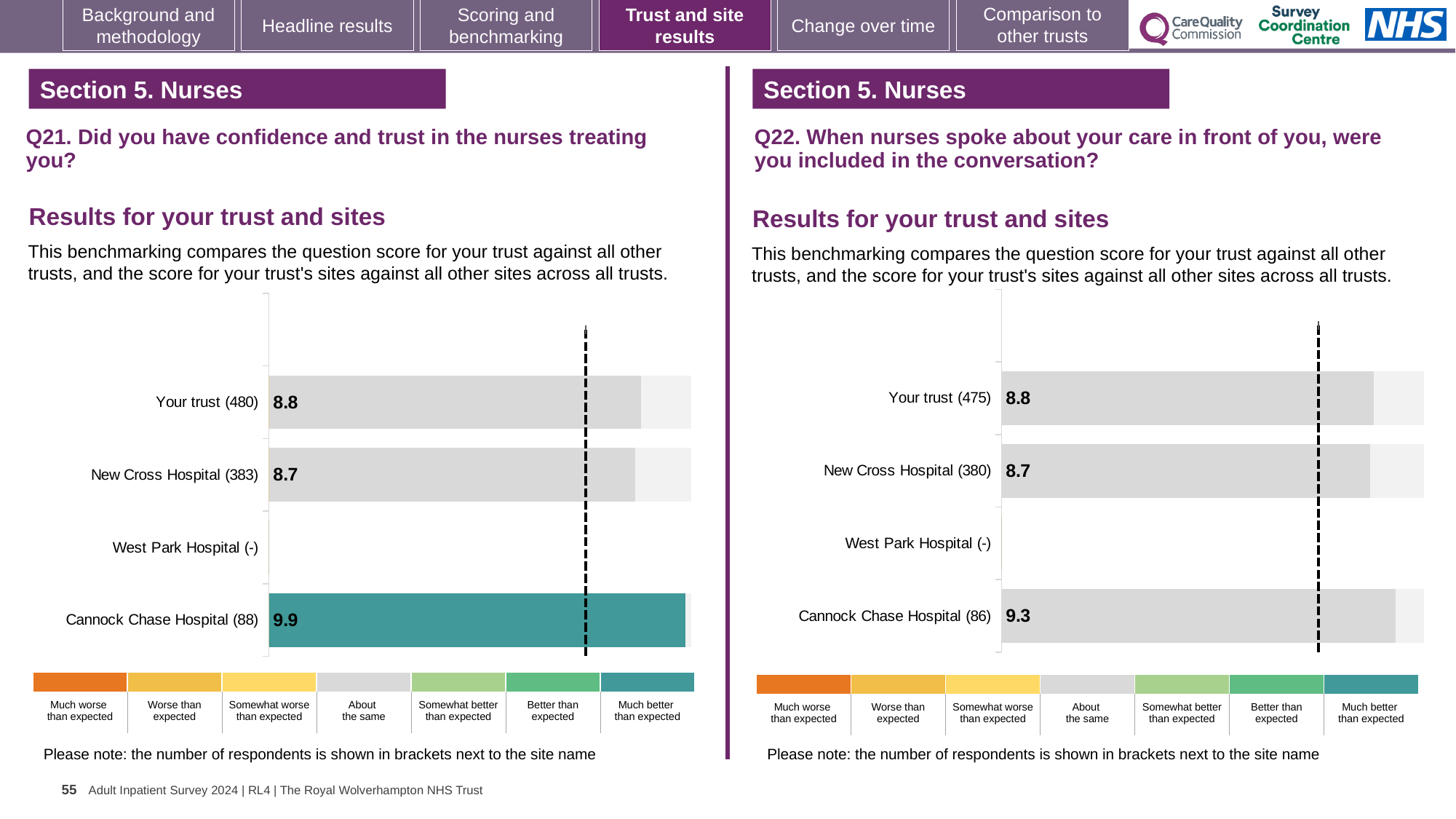
In the Q21 chart (left), which is larger: the score for Your trust or the score for New Cross Hospital? Your trust How many respondents are shown in brackets for Your trust in the Q22 chart (right)? 475 In the Q21 chart (left), which benchmark category does the Cannock Chase Hospital bar colour correspond to? Much better than expected In the Q21 chart (left), what is the score for Your trust? 8.8 What type of chart is used in the Q21 chart (left)? Bar chart In the Q22 chart (right), what is the difference between the Cannock Chase Hospital score and the New Cross Hospital score? 0.6 In the Q21 chart (left), what is the difference between the Cannock Chase Hospital score and the Your trust score? 1.1 In the Q21 chart (left), which site has the highest score? Cannock Chase Hospital In the Q22 chart (right), which site has the highest score? Cannock Chase Hospital In the Q22 chart (right), what is the score for New Cross Hospital? 8.7 In the Q21 chart (left), what is the score for Cannock Chase Hospital? 9.9 In the Q22 chart (right), what is the score for Cannock Chase Hospital? 9.3